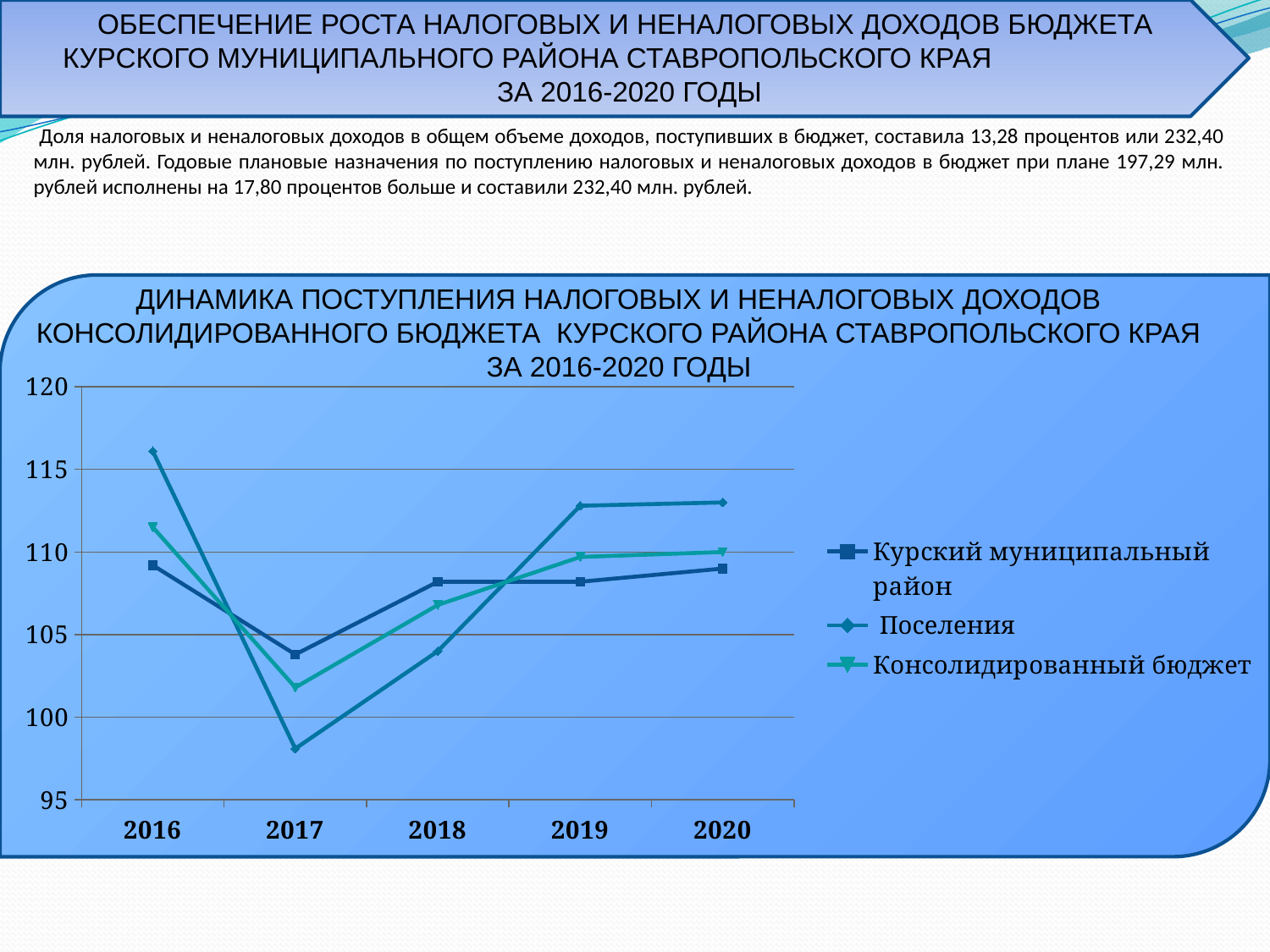
How many series does the chart legend list? 3 What kind of chart is shown on the slide? line chart Is the value for Поселения in 2016 greater or less than 110? greater Which series are listed in the chart legend? Курский муниципальный район, Поселения, Консолидированный бюджет In 2016, which is larger: the value for Поселения or the value for Курский муниципальный район? Поселения In which year is the value for Курский муниципальный район the lowest? 2017 How many years are plotted along the x axis of the chart? 5 Is the value for Консолидированный бюджет in 2017 greater or less than 105? less In which year is the value for Поселения the highest? 2016 Is the value for Поселения in 2017 greater or less than 100? less In which year is the value for Поселения the lowest? 2017 Does the value for Поселения rise or fall from 2017 to 2020? rise